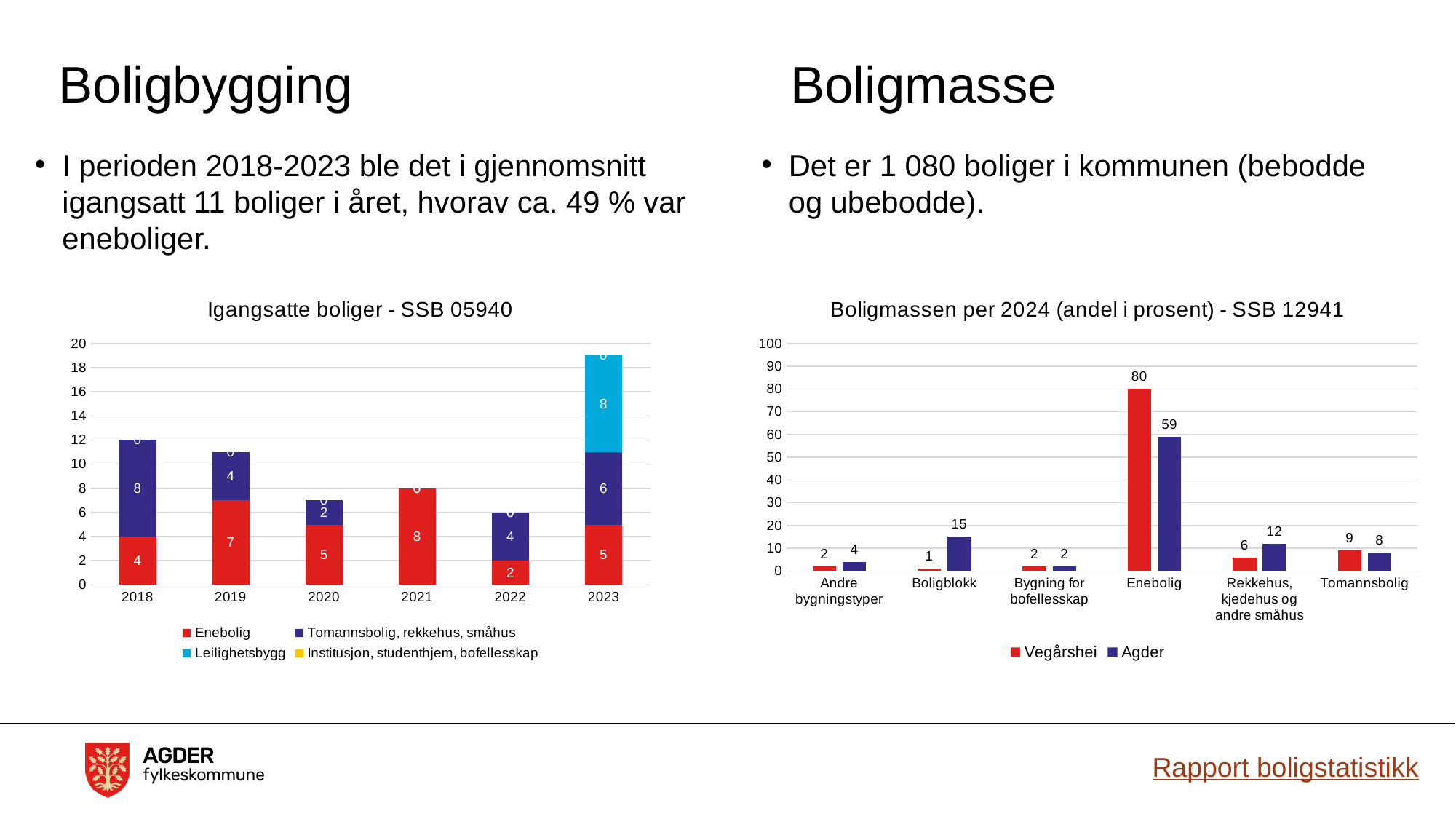
In the chart 'Igangsatte boliger - SSB 05940', what is the total height of the stacked bar for 2023? 19 In the chart 'Igangsatte boliger - SSB 05940', what is the Enebolig value for 2019? 7 In the chart 'Igangsatte boliger - SSB 05940', what is the total height of the stacked bar for 2018? 12 In the chart 'Boligmassen per 2024 (andel i prosent) - SSB 12941', what is the difference between the Vegårshei and Agder values for Enebolig? 21 In the chart 'Igangsatte boliger - SSB 05940', which year has the lowest total of started dwellings? 2022 In the chart 'Boligmassen per 2024 (andel i prosent) - SSB 12941', which is larger for Rekkehus, kjedehus og andre småhus: Vegårshei or Agder? Agder In the chart 'Igangsatte boliger - SSB 05940', how many series does the legend list? 4 In the chart 'Igangsatte boliger - SSB 05940', what is the Leilighetsbygg value for 2023? 8 What kind of chart is 'Boligmassen per 2024 (andel i prosent) - SSB 12941'? Bar chart In the chart 'Boligmassen per 2024 (andel i prosent) - SSB 12941', what is the Vegårshei value for Enebolig? 80 In the chart 'Igangsatte boliger - SSB 05940', how many years are shown on the x axis? 6 In the chart 'Boligmassen per 2024 (andel i prosent) - SSB 12941', what is the Agder value for Boligblokk? 15